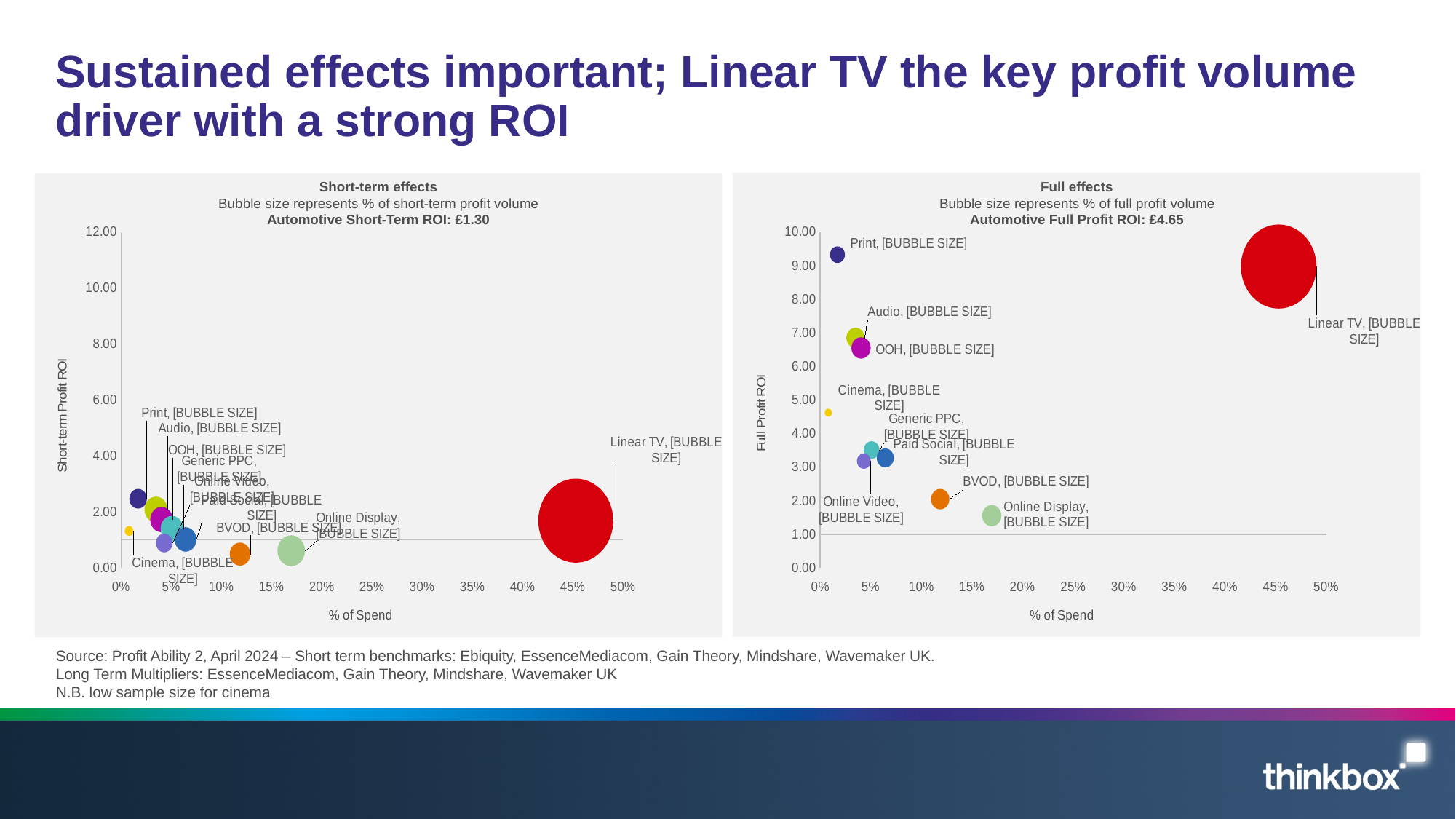
On the 'Full effects' chart, is the Full Profit ROI for Cinema greater or less than 4.00? greater On the 'Short-term effects' chart, is the % of Spend for Linear TV greater or less than 40%? greater On the 'Short-term effects' chart, which channel has the largest bubble? Linear TV What type of chart is the 'Short-term effects' chart? Bubble chart On the 'Short-term effects' chart, is the Short-term Profit ROI for Linear TV greater or less than 4.00? less On the 'Full effects' chart, which channel has the lowest Full Profit ROI? Online Display On the 'Full effects' chart, which has the higher Full Profit ROI, Audio or BVOD? Audio How many media channels are plotted as bubbles on the 'Full effects' chart? 10 What Automotive Full Profit ROI is stated in the title of the 'Full effects' chart? £4.65 On the 'Full effects' chart, which channel has the highest % of Spend? Linear TV